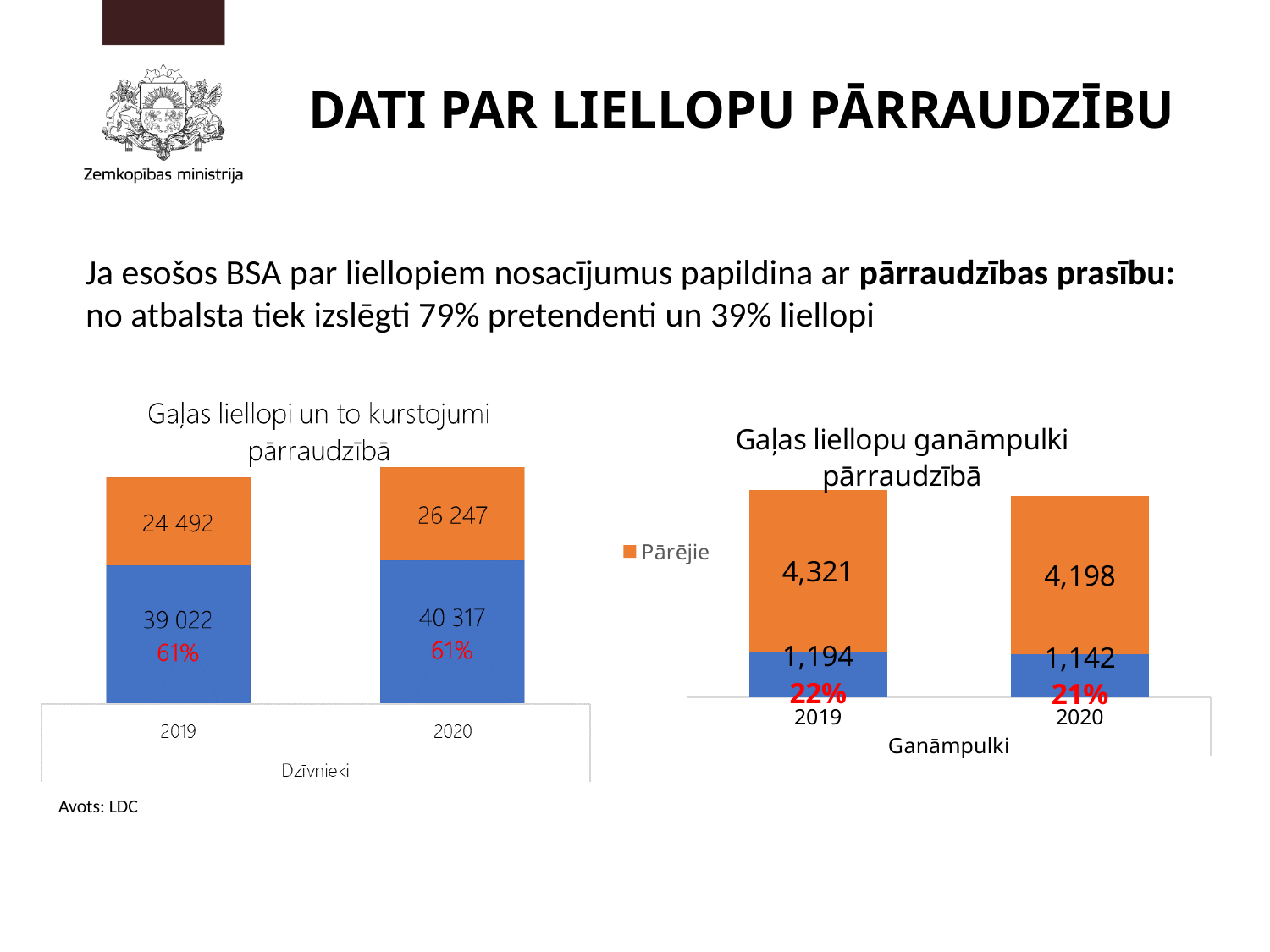
In the chart titled 'Gaļas liellopi un to kurstojumi pārraudzībā', what is the value of the orange segment for 2019? 24 492 In the chart titled 'Gaļas liellopu ganāmpulki pārraudzībā', which year has the larger blue segment, 2019 or 2020? 2019 In the chart titled 'Gaļas liellopu ganāmpulki pārraudzībā', what percentage is shown on the blue segment for 2019? 22% What kind of chart is the chart titled 'Gaļas liellopu ganāmpulki pārraudzībā'? Stacked bar chart In the chart titled 'Gaļas liellopu ganāmpulki pārraudzībā', what is the total of the stacked bar for 2019? 5,515 In the chart titled 'Gaļas liellopu ganāmpulki pārraudzībā', what is the difference between the 'Pārējie' values for 2019 and 2020? 123 In the chart titled 'Gaļas liellopu ganāmpulki pārraudzībā', what is the value of the 'Pārējie' segment for 2020? 4,198 How many years are shown on the x axis of the chart titled 'Gaļas liellopi un to kurstojumi pārraudzībā'? 2 What is the x-axis title of the chart titled 'Gaļas liellopu ganāmpulki pārraudzībā'? Ganāmpulki In the chart titled 'Gaļas liellopi un to kurstojumi pārraudzībā', what is the value of the blue segment for 2020? 40 317 In the chart titled 'Gaļas liellopi un to kurstojumi pārraudzībā', what is the total of the stacked bar for 2020? 66 564 In the chart titled 'Gaļas liellopi un to kurstojumi pārraudzībā', by how much did the orange segment increase from 2019 to 2020? 1 755